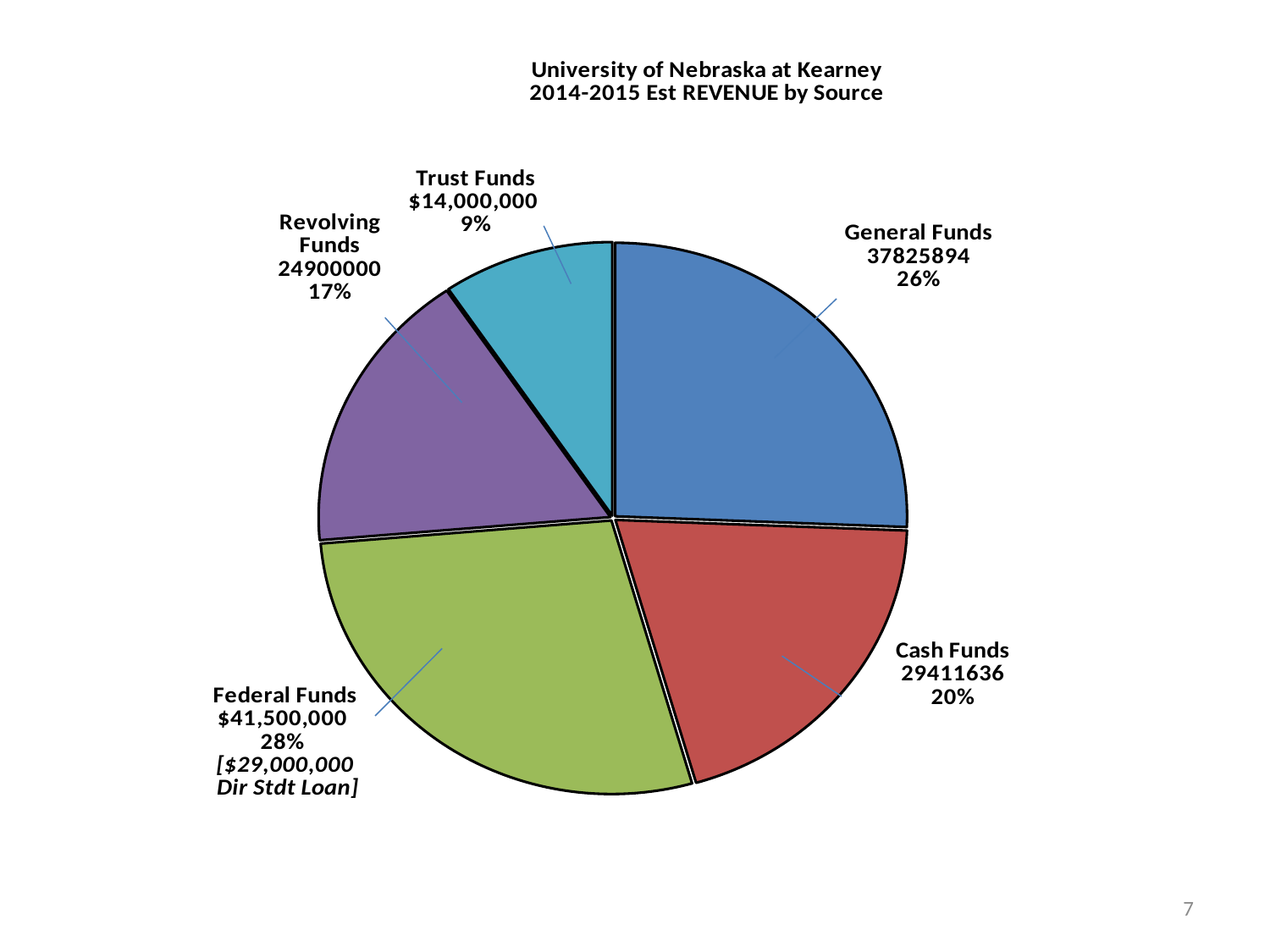
Which revenue source has the largest slice of the pie? Federal Funds What is the difference between the Federal Funds value and the Trust Funds value? $27,500,000 What is the value shown for Revolving Funds? 24900000 Which revenue source has the smallest slice of the pie? Trust Funds What is the value shown for General Funds? 37825894 What type of chart is shown on the slide? Pie chart Which is larger, General Funds or Cash Funds? General Funds What is the value shown for Federal Funds? $41,500,000 What is the value shown for Trust Funds? $14,000,000 What share of the pie does Federal Funds represent? 28% What share of the pie does Cash Funds represent? 20% How many revenue sources are shown in the pie chart? 5